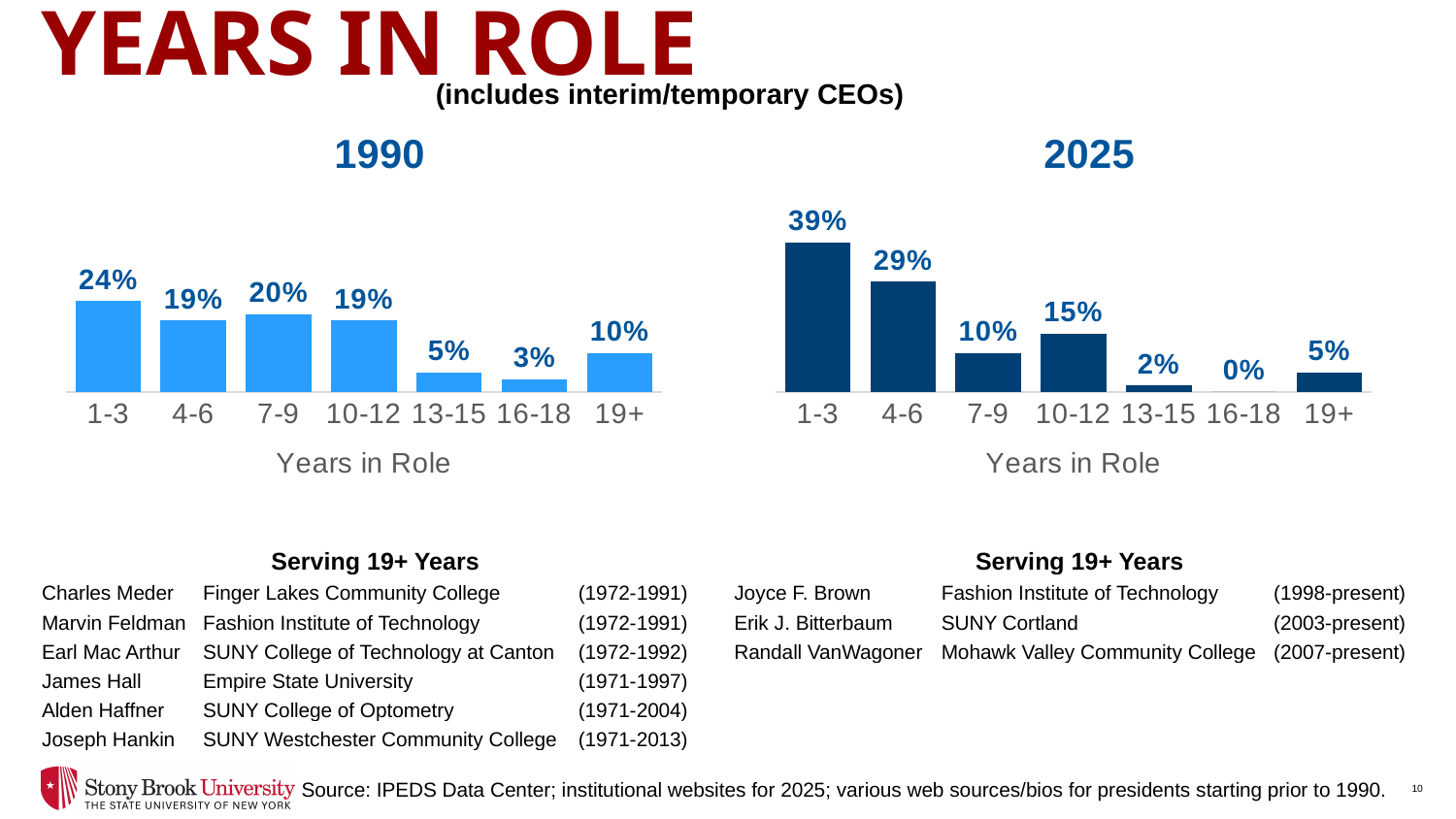
In the 2025 chart, what percentage of CEOs had been in their role for 4-6 years? 29% In the 1990 chart, what percentage of CEOs had been in their role for 1-3 years? 24% Which chart has the higher value for the 10-12 years category, 1990 or 2025? 1990 In the 2025 chart, which years-in-role category has the highest value? 1-3 In the 2025 chart, what is the difference between the 1-3 and 4-6 categories? 10% How many years-in-role categories are shown in the 1990 chart? 7 In the 1990 chart, which years-in-role category has the lowest value? 16-18 What type of chart is used for the 2025 data? Bar chart In the 2025 chart, what is the value for the 16-18 years category? 0% In the 1990 chart, what is the difference between the 13-15 and 16-18 categories? 2% In the 1990 chart, which is larger: the value for 7-9 years or the value for 19+ years? 7-9 years What is the x-axis title of the 1990 chart? Years in Role